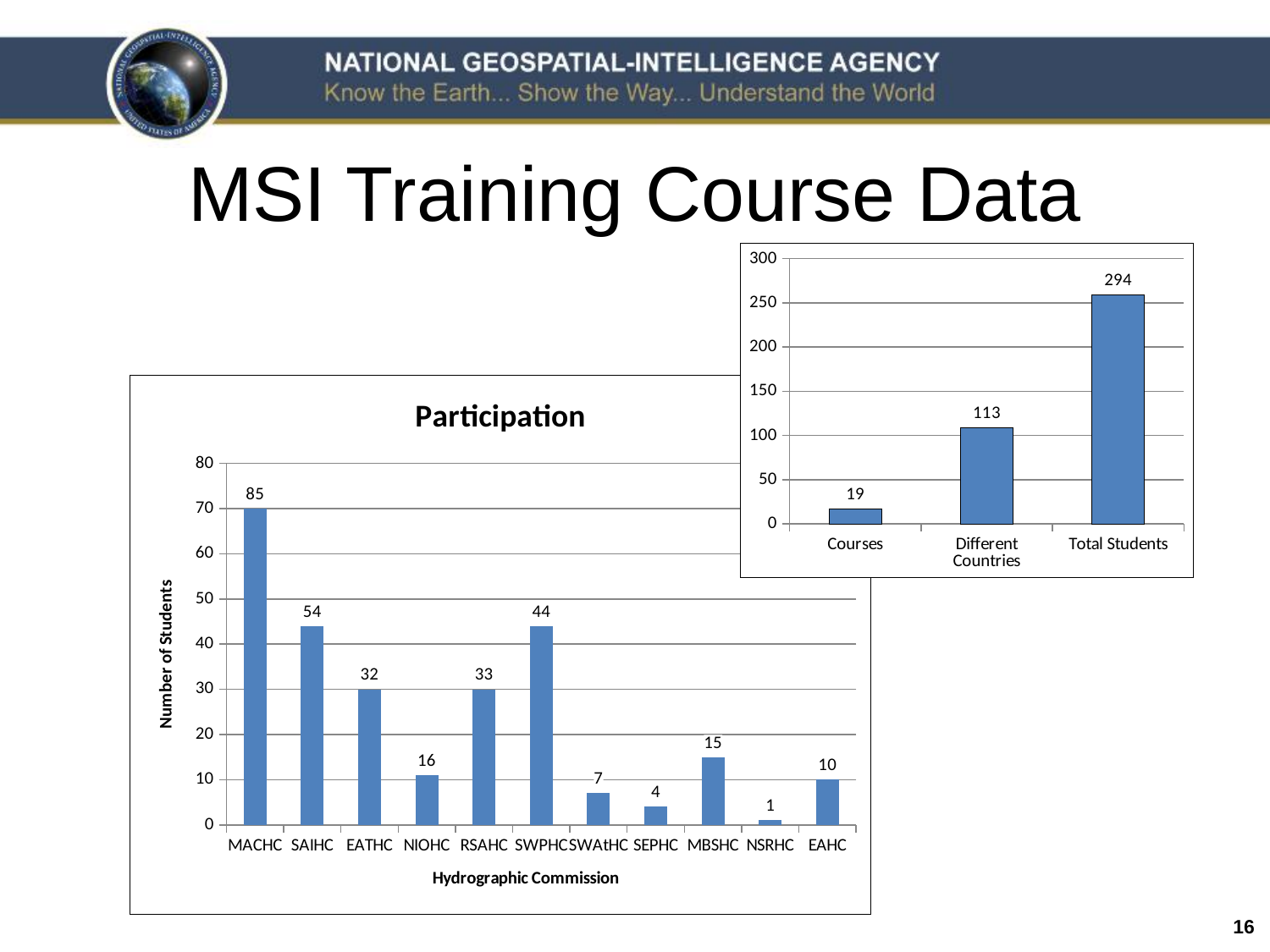
In the chart at the top right of the slide, what is the value for Different Countries? 113 In the Participation chart, what is the title of the y axis? Number of Students In the chart at the top right of the slide, which category has the lowest value? Courses In the Participation chart, which hydrographic commission has the lowest number of students? NSRHC In the Participation chart, what is the value for SWPHC? 44 In the Participation chart, what is the value for MACHC? 85 In the Participation chart, which hydrographic commission has the highest number of students? MACHC In the Participation chart, what is the value for NIOHC? 16 In the Participation chart, how many hydrographic commissions are shown on the x axis? 11 In the chart at the top right of the slide, what is the difference between Total Students and Different Countries? 181 What kind of chart is the Participation chart? bar chart In the Participation chart, which is larger, the value for SAIHC or the value for SWPHC? SAIHC